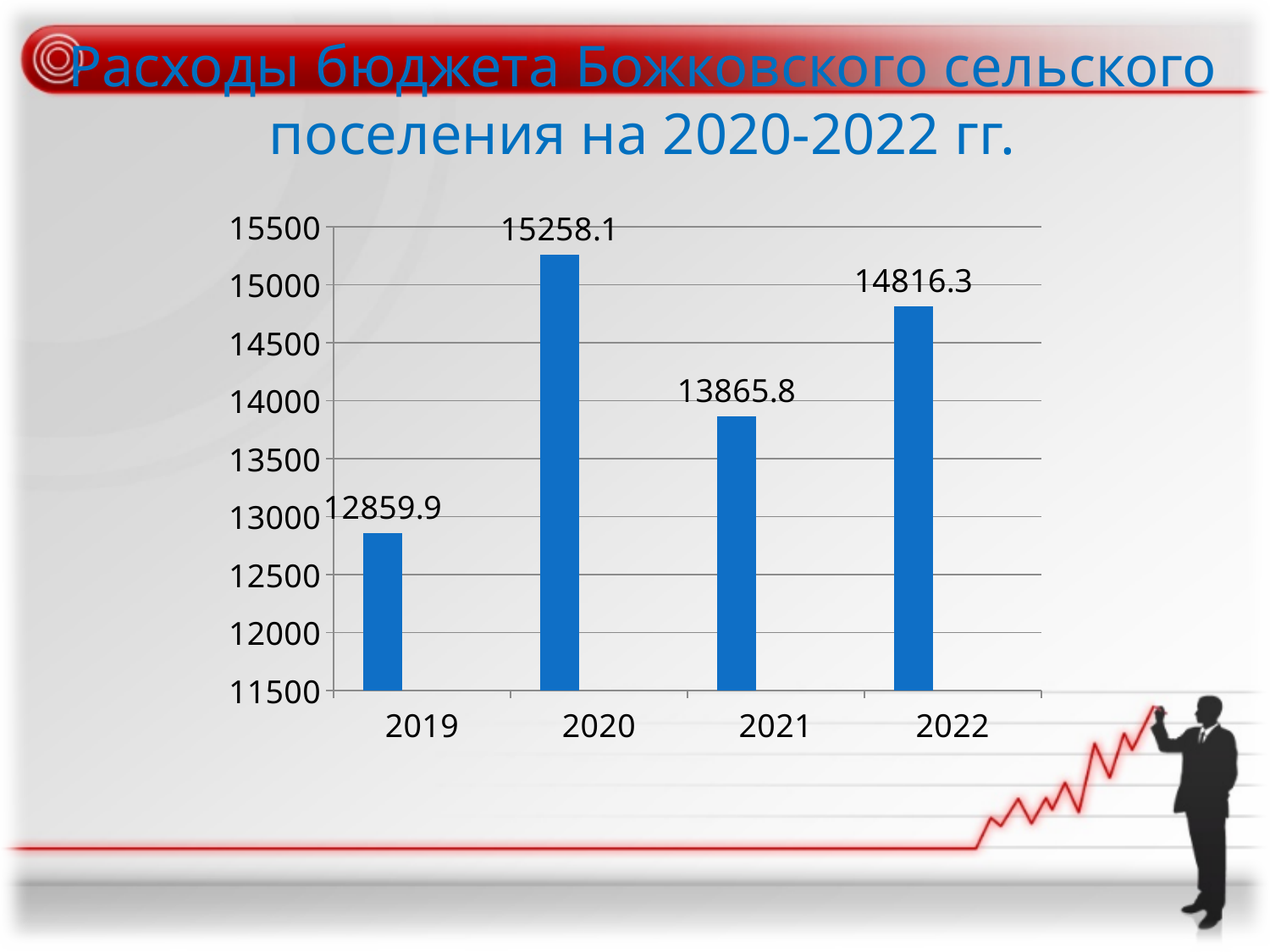
Which year has the lowest value? 2019 What is the difference between the values for 2020 and 2019? 2398.2 What is the value for 2021? 13865.8 How many years are shown on the x axis? 4 What is the value for 2020? 15258.1 What kind of chart is shown on the slide? bar chart What is the value for 2019? 12859.9 What is the value for 2022? 14816.3 Which year has the highest value? 2020 Is the value for 2019 greater or less than 13000? less What is the difference between the values for 2022 and 2021? 950.5 Which is larger, the value for 2021 or the value for 2022? 2022